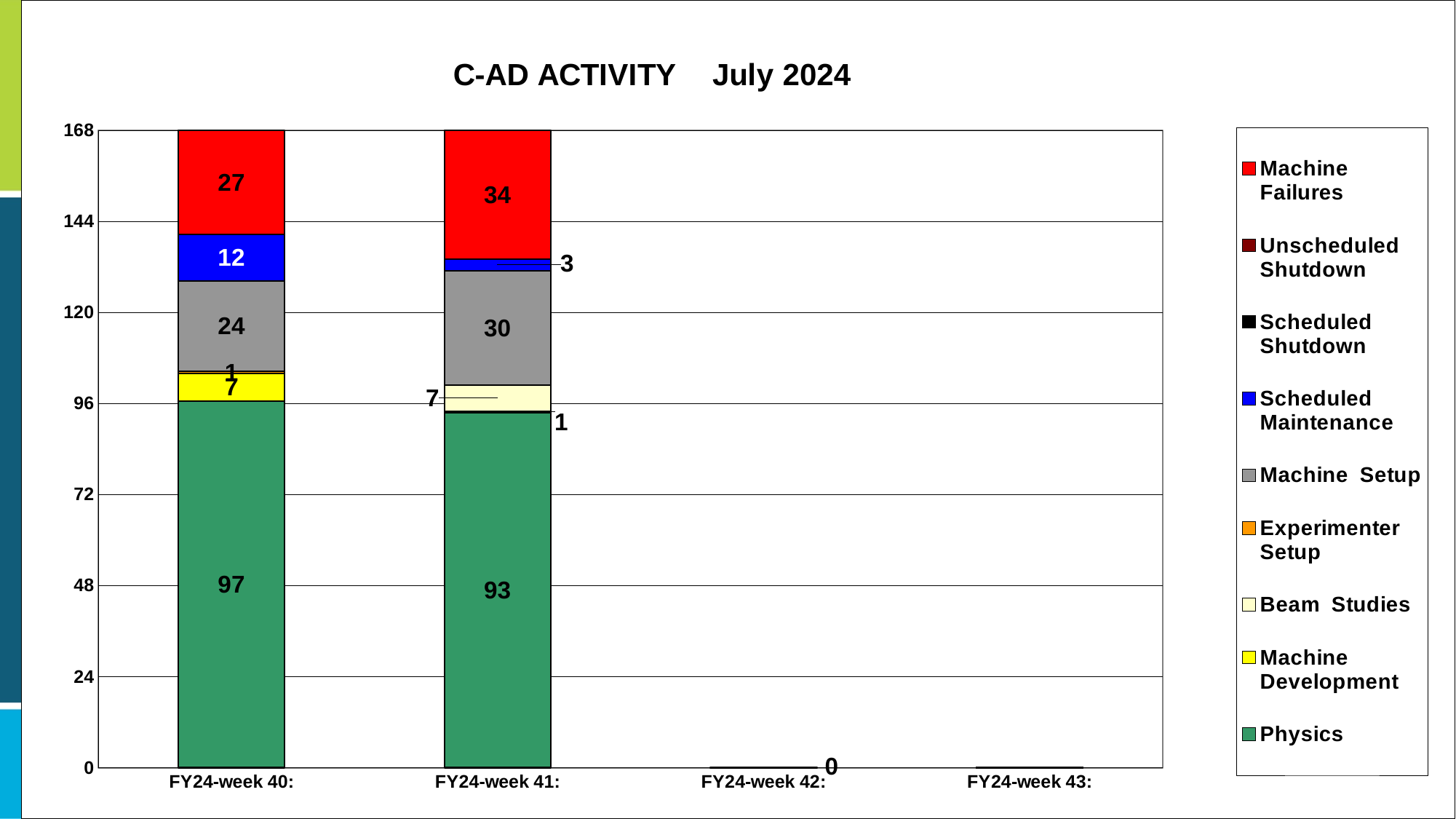
What is the total of the stacked bar for FY24-week 40? 168 What is the value for Machine Development in FY24-week 40? 7 How many series does the legend list? 9 What kind of chart is shown on the slide? Stacked bar chart Which week has the larger Physics value, FY24-week 40 or FY24-week 41? FY24-week 40 What is the difference between the Machine Failures values for FY24-week 41 and FY24-week 40? 7 What is the difference between the Machine Setup values for FY24-week 41 and FY24-week 40? 6 What is the value for Machine Failures in FY24-week 41? 34 What is the value for Physics in FY24-week 40? 97 What is the value for Scheduled Maintenance in FY24-week 41? 3 What is the value for Machine Setup in FY24-week 40? 24 What is the title of the chart? C-AD ACTIVITY July 2024